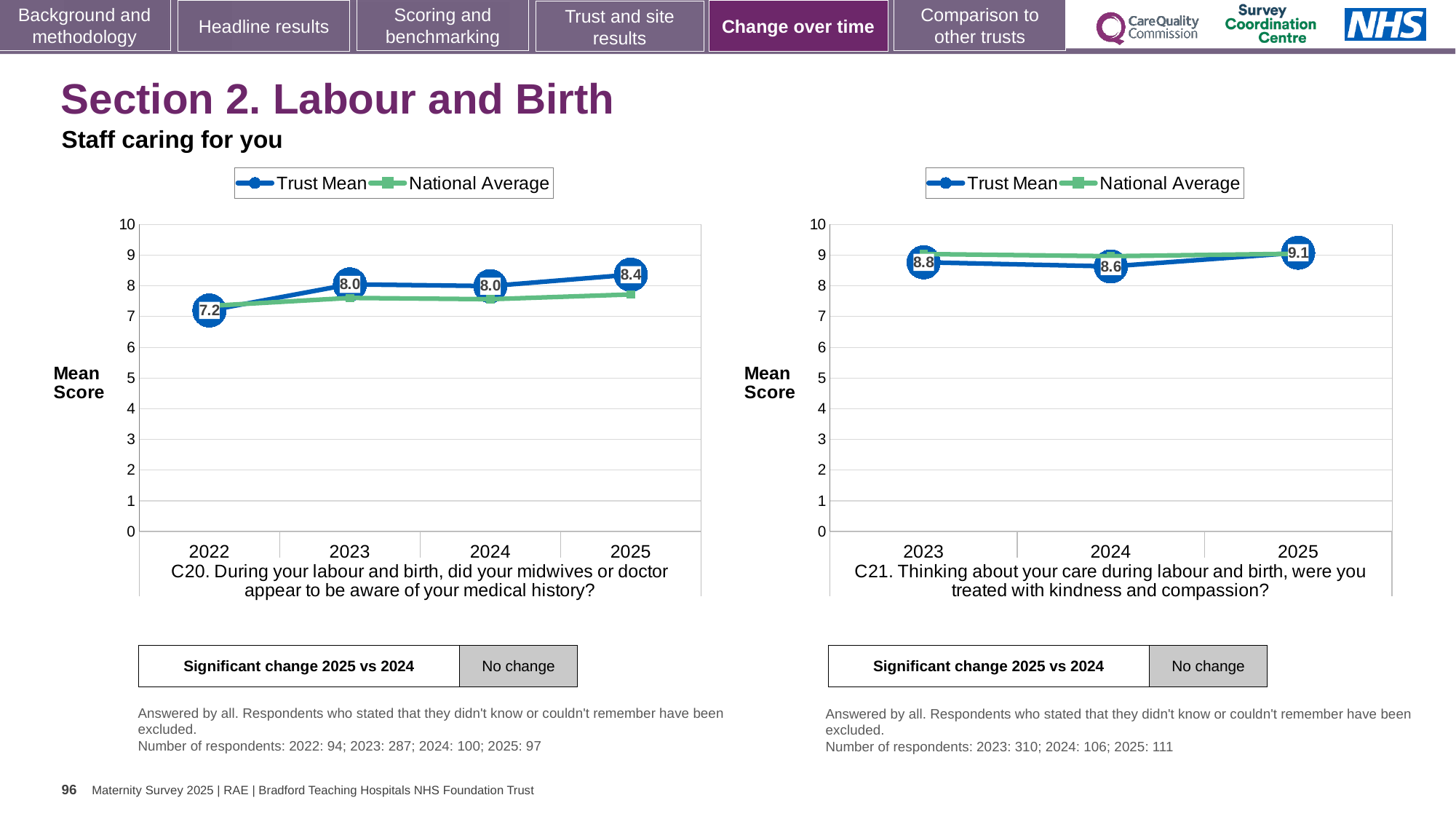
On the C20 chart (left), what is the Trust Mean score for 2025? 8.4 On the C21 chart (right), how many series does the legend list? 2 On the C20 chart (left), what is the Trust Mean score for 2022? 7.2 On the C20 chart (left), which year has the highest Trust Mean score? 2025 On the C20 chart (left), does the Trust Mean generally rise or fall from 2022 to 2025? rise On the C21 chart (right), what is the Trust Mean score for 2024? 8.6 On the C20 chart (left), how many years are plotted on the x axis? 4 On the C20 chart (left), what is the difference between the Trust Mean scores for 2025 and 2022? 1.2 On the C20 chart (left), which year has the lowest Trust Mean score? 2022 On the C21 chart (right), is the Trust Mean score for 2023 larger or smaller than the score for 2024? larger On the C21 chart (right), which year has the highest Trust Mean score? 2025 What type of chart is the C21 chart (right)? line chart